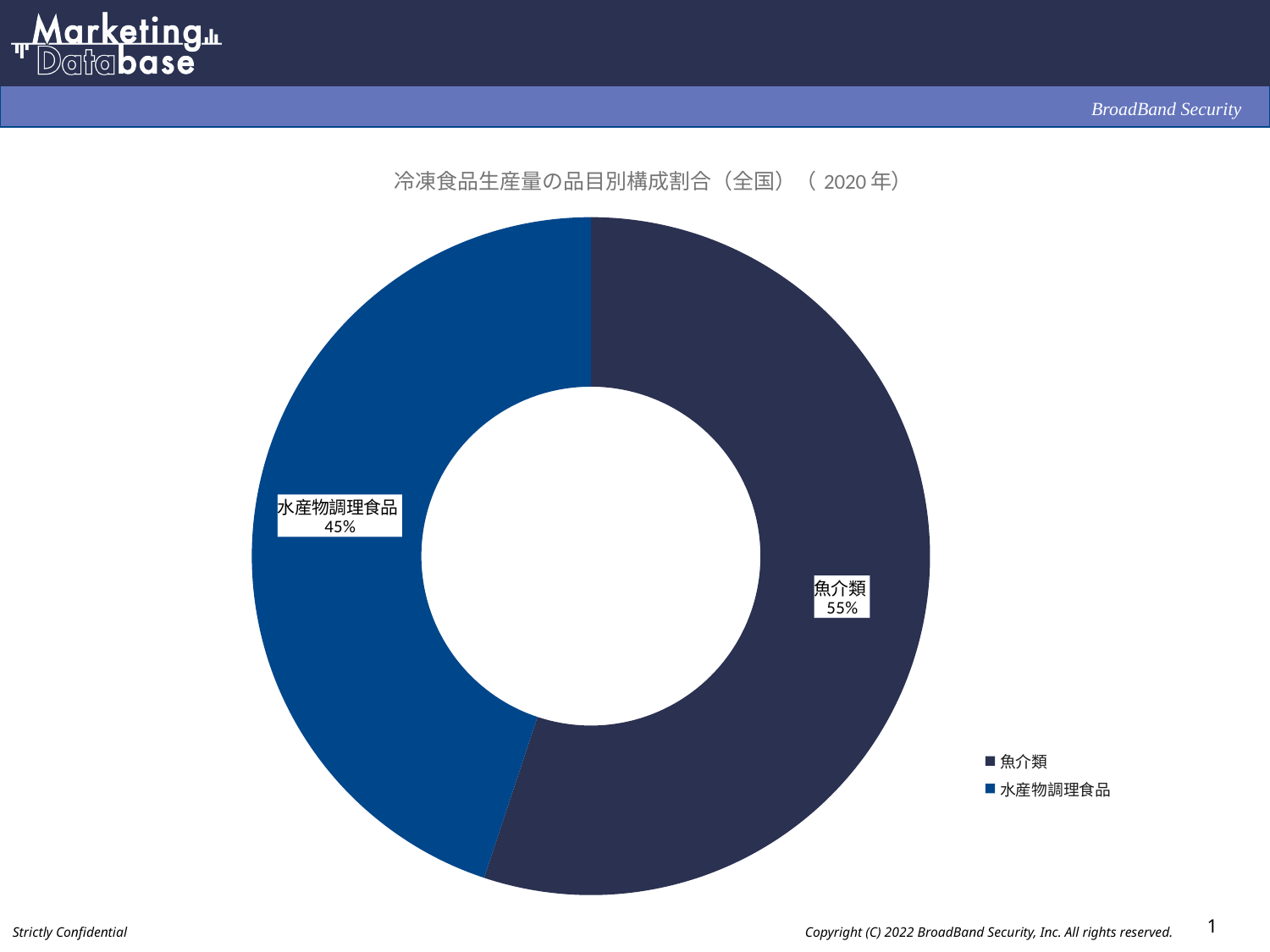
Which category is shown in the lighter blue colour? 水産物調理食品 How many entries does the legend list? 2 Which category has the smallest share? 水産物調理食品 What is the difference in percentage points between the share of 魚介類 and the share of 水産物調理食品? 10 percentage points What is the title of the chart? 冷凍食品生産量の品目別構成割合（全国）（2020年） What is the total of the two shares shown in the chart? 100% Which is larger, the share of 魚介類 or the share of 水産物調理食品? 魚介類 What kind of chart is shown on the slide? Pie (doughnut) chart What share of the pie does 水産物調理食品 account for? 45% How many categories are shown in the chart? 2 What share of the pie does 魚介類 account for? 55% Which category has the largest share? 魚介類